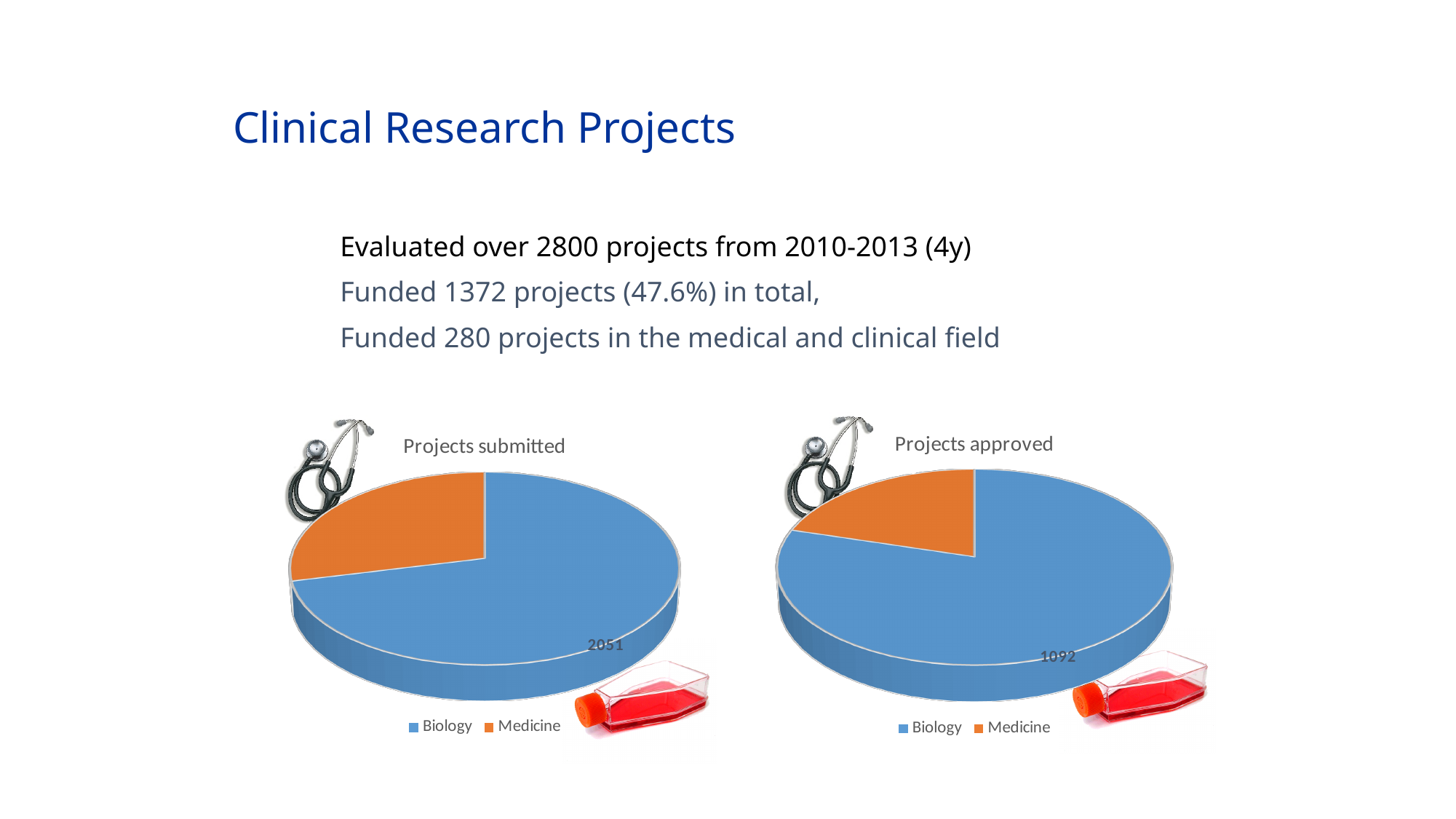
What is the difference between the Biology value in the 'Projects submitted' chart and the Biology value in the 'Projects approved' chart? 959 In the 'Projects submitted' chart, which category has the largest slice? Biology What kind of chart is the 'Projects submitted' chart? Pie chart What is the title of the pie chart on the left of the slide? Projects submitted In the 'Projects approved' chart, what colour is the Medicine slice? Orange Which is larger: the Biology value in the 'Projects submitted' chart or the Biology value in the 'Projects approved' chart? Projects submitted In the 'Projects approved' chart, which category has the smallest slice? Medicine What kind of chart is the 'Projects approved' chart? Pie chart How many slices does the 'Projects approved' chart have? 2 How many entries does the legend of the 'Projects submitted' chart list? 2 In the 'Projects approved' chart, what is the value for Biology? 1092 In the 'Projects submitted' chart, what is the value for Biology? 2051